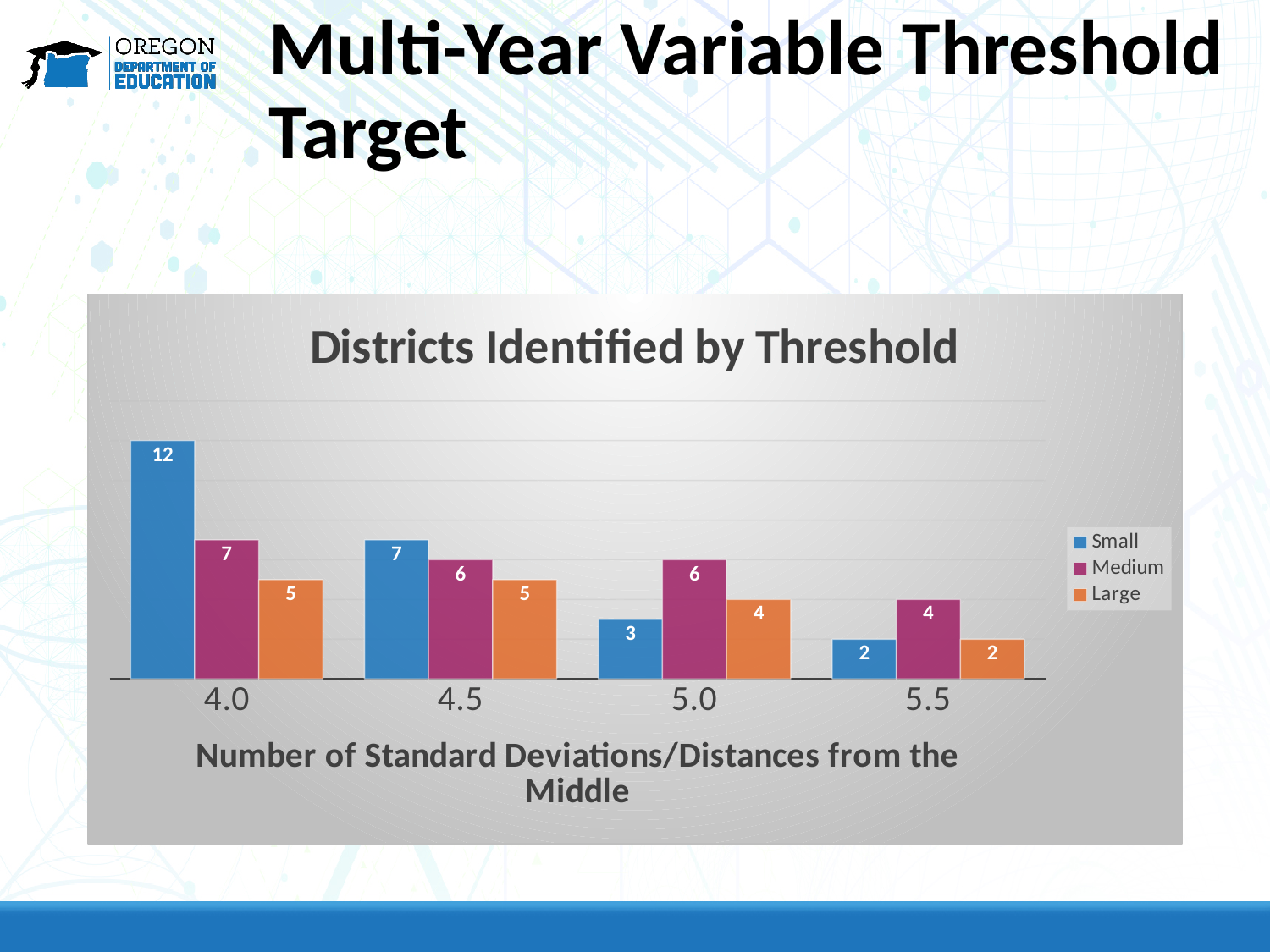
How many threshold categories are shown on the x axis? 4 What is the value for Small at threshold 4.0? 12 How many series does the legend list? 3 At which threshold is the Large series lowest? 5.5 What is the value for Large at threshold 5.5? 2 What kind of chart is shown? bar chart What is the difference between Small and Medium at threshold 4.0? 5 Does the Small series rise or fall as the threshold increases from 4.0 to 5.5? fall At which threshold is the Small series highest? 4.0 What is the value for Medium at threshold 5.0? 6 Which is larger at threshold 5.0, Small or Medium? Medium What is the title of the chart? Districts Identified by Threshold